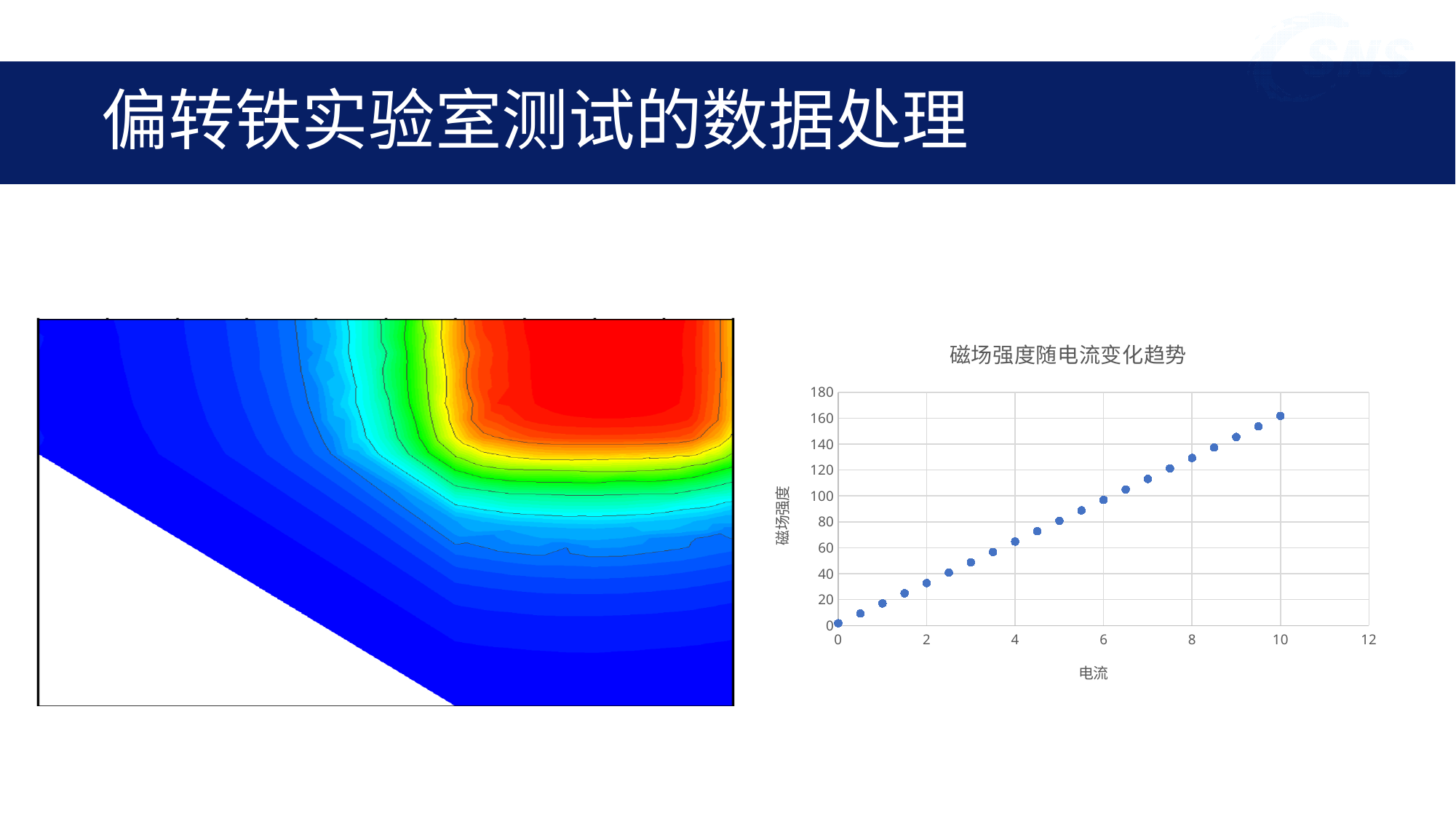
In the chart titled 磁场强度随电流变化趋势, is the value at 电流 = 10 greater or less than 140? greater In the chart titled 磁场强度随电流变化趋势, is the value at 电流 = 4 greater or less than 80? less In the chart titled 磁场强度随电流变化趋势, do the values rise or fall as 电流 increases? rise In the chart titled 磁场强度随电流变化趋势, is the value at 电流 = 6 greater or less than 80? greater What kind of chart is the chart titled 磁场强度随电流变化趋势? scatter chart In the chart titled 磁场强度随电流变化趋势, at which 电流 value is 磁场强度 lowest? 0 What is the label of the vertical axis in the chart titled 磁场强度随电流变化趋势? 磁场强度 In the chart titled 磁场强度随电流变化趋势, at which 电流 value is 磁场强度 highest? 10 In the chart titled 磁场强度随电流变化趋势, which has the larger 磁场强度: 电流 = 8 or 电流 = 4? 电流 = 8 How many data points are plotted in the chart titled 磁场强度随电流变化趋势? 21 What is the title of the scatter chart on the right of the slide? 磁场强度随电流变化趋势